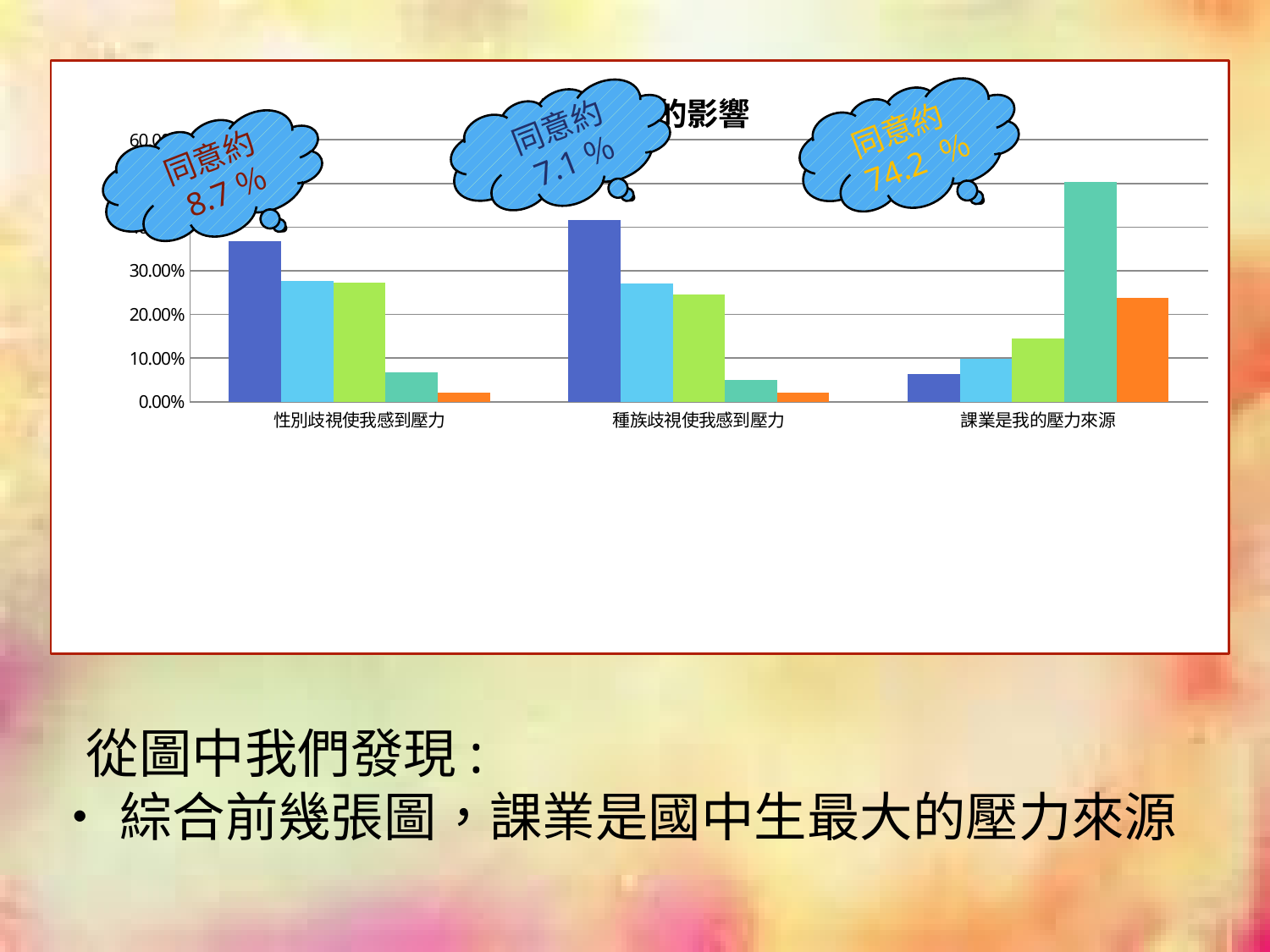
How many categories are shown on the x axis of the chart? 3 Is the value of the orange bar for 課業是我的壓力來源 greater or less than 20.00%? greater What percentage does the thought bubble above 課業是我的壓力來源 state? 74.2 % Which category contains the tallest bar in the chart? 課業是我的壓力來源 Is the value of the dark blue bar for 課業是我的壓力來源 greater or less than 10.00%? less Is the value of the teal bar for 性別歧視使我感到壓力 greater or less than 10.00%? less Which is larger: the orange bar for 課業是我的壓力來源 or the orange bar for 種族歧視使我感到壓力? 課業是我的壓力來源 Which category has the shortest dark blue bar? 課業是我的壓力來源 What kind of chart is shown on the slide? bar chart Which is larger: the dark blue bar for 性別歧視使我感到壓力 or the dark blue bar for 種族歧視使我感到壓力? 種族歧視使我感到壓力